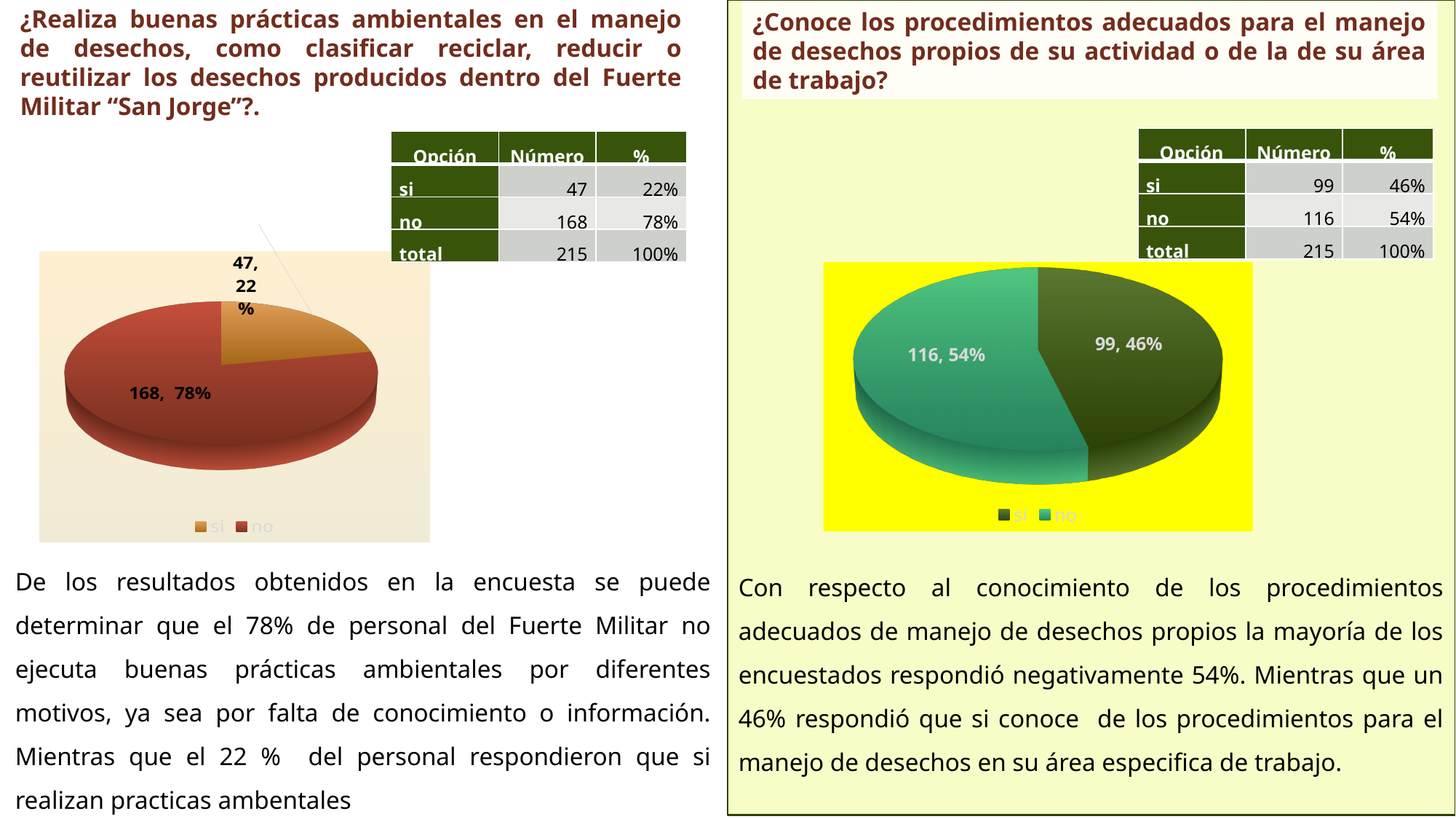
In the pie chart on the right side of the slide, which slice is the smallest? si In the pie chart on the right side of the slide, what percentage is shown for the "no" slice? 54% In the pie chart on the right side of the slide, which slice is larger, "si" or "no"? no In the pie chart on the left side of the slide, what value is shown for the "no" slice? 168, 78% How many slices does the pie chart on the right side of the slide have? 2 In the pie chart on the right side of the slide, what value is shown for the "si" slice? 99, 46% In the pie chart on the right side of the slide, what is the difference in count between the "no" and "si" slices? 17 What entries does the legend of the pie chart on the left side of the slide list? si, no In the pie chart on the left side of the slide, which slice is the largest? no In the pie chart on the left side of the slide, what percentage is shown for the "si" slice? 22% In the pie chart on the left side of the slide, what is the difference in count between the "no" and "si" slices? 121 What type of chart is shown on the left side of the slide? Pie chart